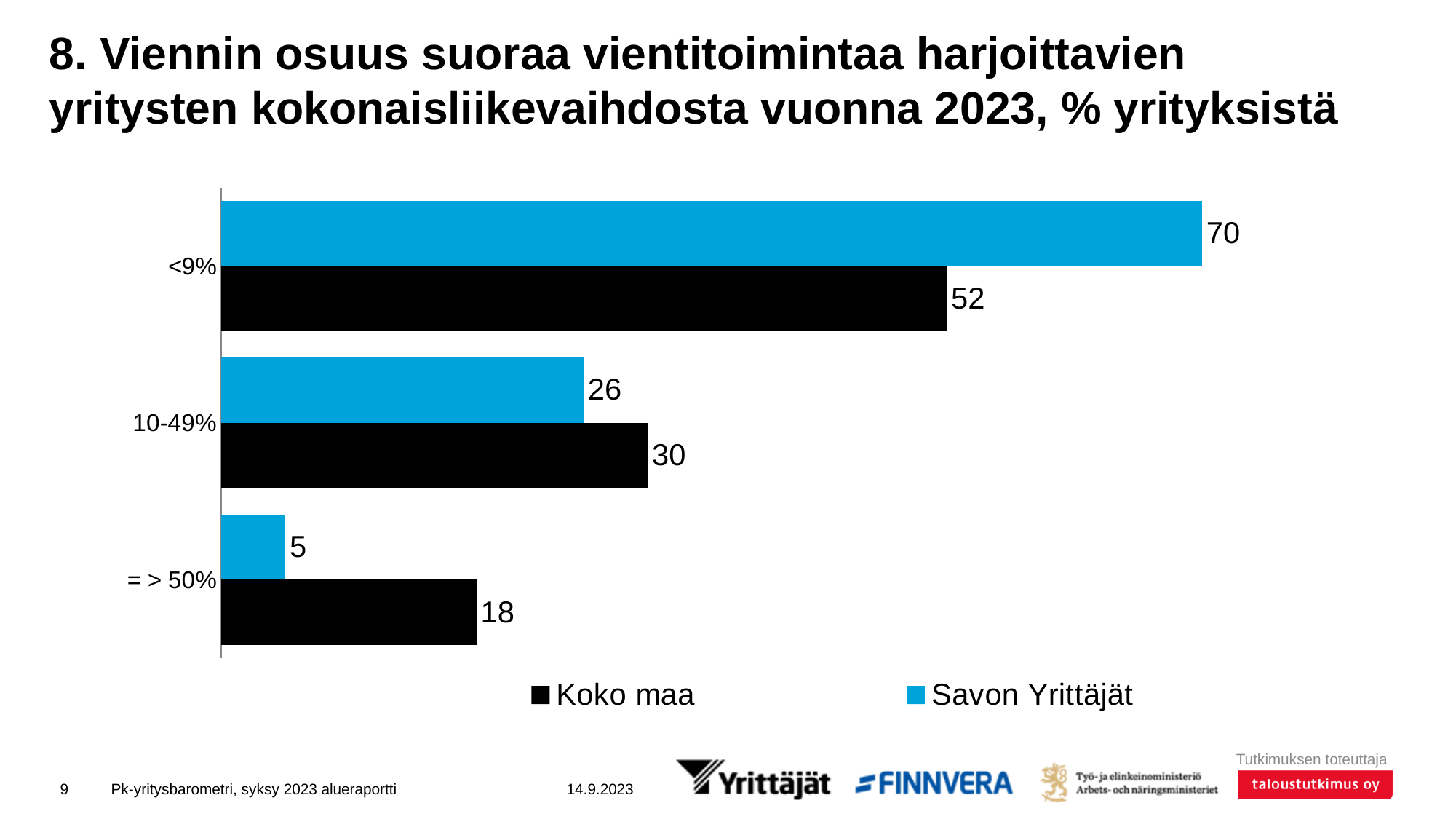
What is the value for Savon Yrittäjät in the <9% category? 70 How many categories are shown on the chart? 3 What is the value for Koko maa in the = > 50% category? 18 How many series does the legend list? 2 What is the difference between Savon Yrittäjät and Koko maa in the <9% category? 18 In the 10-49% category, which series has the larger value, Koko maa or Savon Yrittäjät? Koko maa Which colour represents Savon Yrittäjät in the chart? Blue Which category has the lowest value for Koko maa? = > 50% What is the value for Savon Yrittäjät in the 10-49% category? 26 What is the value for Koko maa in the <9% category? 52 Which category has the highest value for Savon Yrittäjät? <9% What kind of chart is shown on the slide? Bar chart